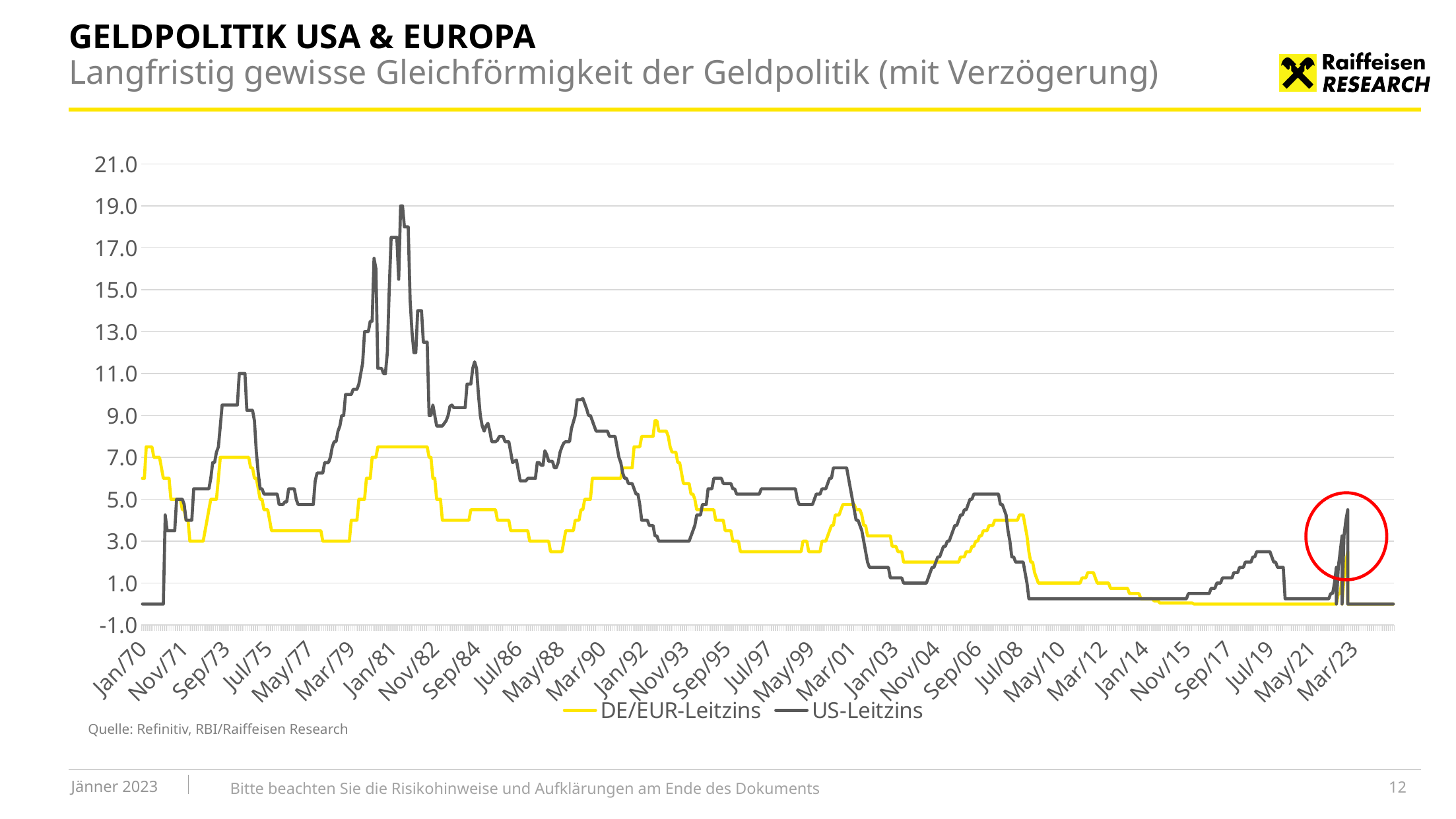
Around Jan/81, which series has the higher value, DE/EUR-Leitzins or US-Leitzins? US-Leitzins Is the peak value of DE/EUR-Leitzins around Nov/92 greater or less than 7.0? greater Around Jul/08, which series has the higher value, DE/EUR-Leitzins or US-Leitzins? DE/EUR-Leitzins Which series reaches the highest value anywhere on the chart? US-Leitzins Does the US-Leitzins series overall rise or fall between Jan/81 and Jan/14? fall Is the peak value of US-Leitzins around Jan/81 greater or less than 15.0? greater Which series is drawn in yellow? DE/EUR-Leitzins What are the two series named in the legend? DE/EUR-Leitzins and US-Leitzins How many series does the legend list? 2 What kind of chart is shown on the slide? line chart Around Nov/92, which series has the higher value, DE/EUR-Leitzins or US-Leitzins? DE/EUR-Leitzins Is the value of DE/EUR-Leitzins around Jan/14 greater or less than 1.0? less